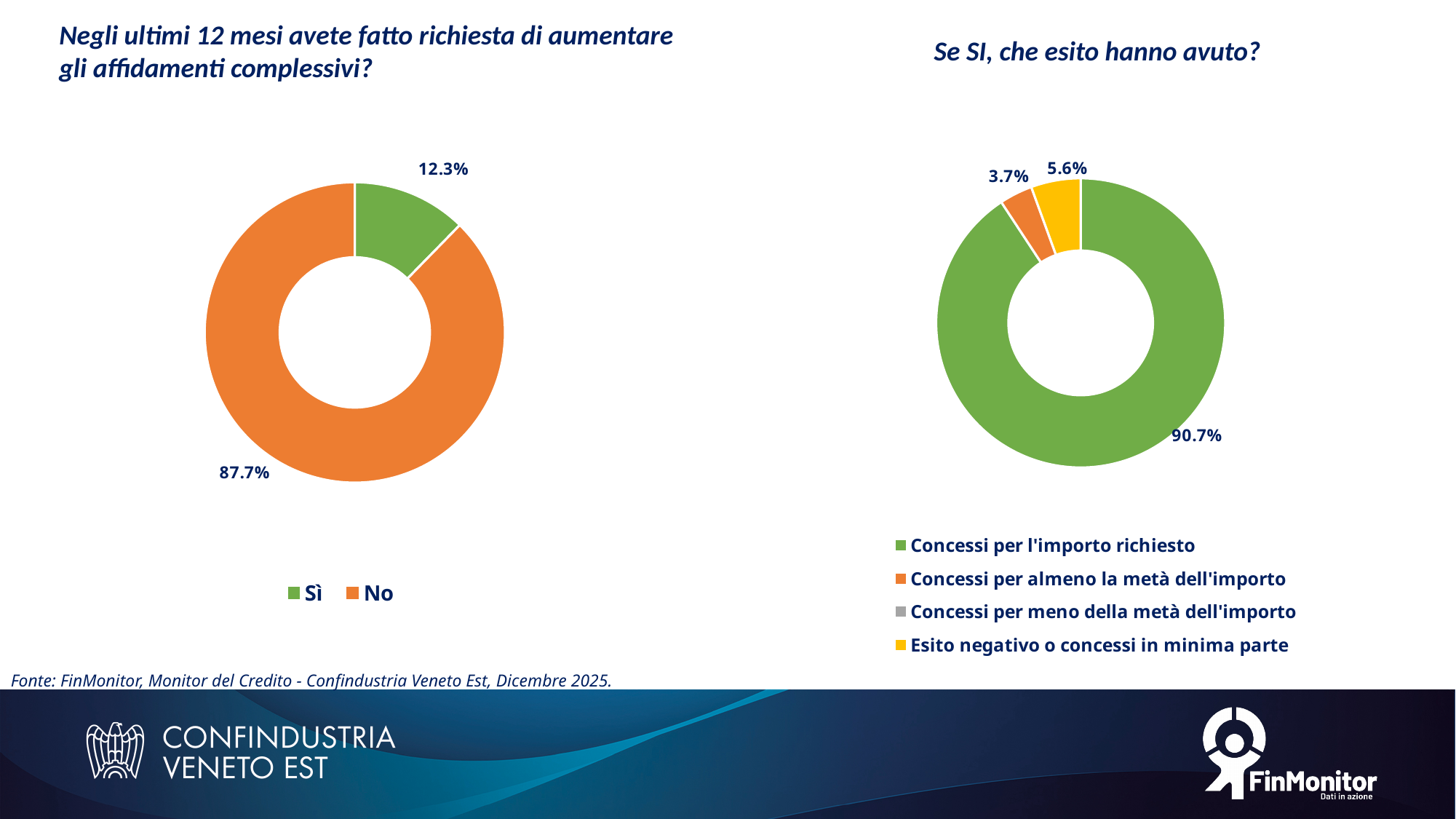
In the right chart, what percentage corresponds to "Esito negativo o concessi in minima parte"? 5.6% How many categories does the legend of the left chart list? 2 In the left chart, what is the difference in percentage points between "No" and "Sì"? 75.4 In the right chart ("Se SI, che esito hanno avuto?"), what percentage corresponds to "Concessi per l'importo richiesto"? 90.7% What type of chart is used on the left side of the slide? Donut (pie) chart In the right chart, what percentage corresponds to "Concessi per almeno la metà dell'importo"? 3.7% In the left chart, which answer has the larger share, "Sì" or "No"? No How many entries does the legend of the right chart list? 4 In the right chart, which category has the largest share? Concessi per l'importo richiesto In the right chart, which is larger: "Esito negativo o concessi in minima parte" or "Concessi per almeno la metà dell'importo"? Esito negativo o concessi in minima parte In the left chart ("Negli ultimi 12 mesi avete fatto richiesta di aumentare gli affidamenti complessivi?"), what percentage answered "Sì"? 12.3% In the left chart, what percentage answered "No"? 87.7%